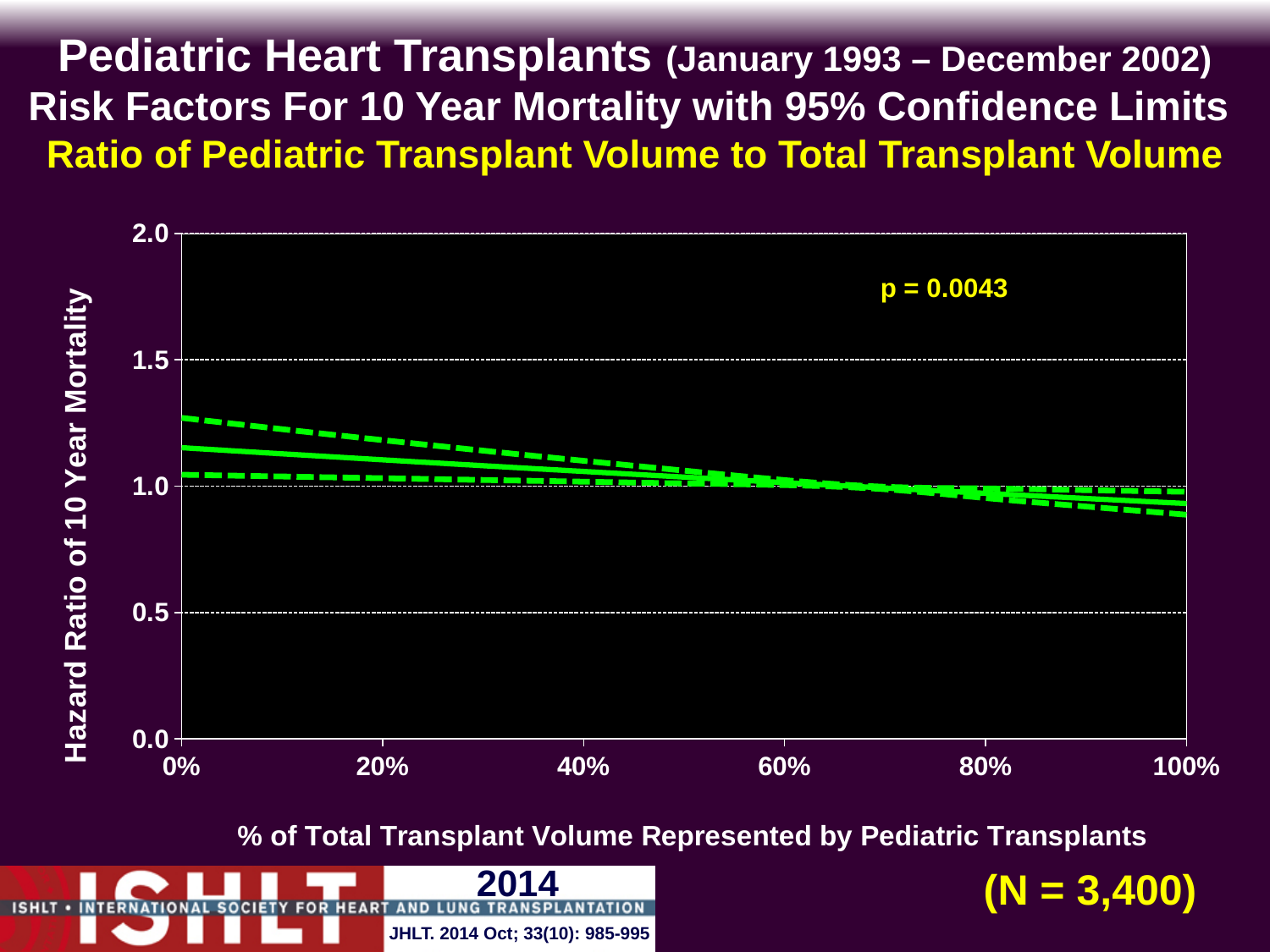
Is the hazard ratio higher at 0% or at 100% pediatric transplant volume? 0% Is the hazard ratio at 100% pediatric transplant volume greater or less than 1.0? less Does the hazard ratio of 10 year mortality rise or fall as the % of total transplant volume represented by pediatric transplants increases from 0% to 100%? fall How many tick labels are shown on the x axis? 6 Is the lower 95% confidence limit at 100% pediatric transplant volume greater or less than 0.5? greater What is the maximum value shown on the y axis? 2.0 What kind of chart is shown on the slide? line chart What p-value is printed on the chart? p = 0.0043 Is the hazard ratio at 0% pediatric transplant volume greater or less than 1.0? greater